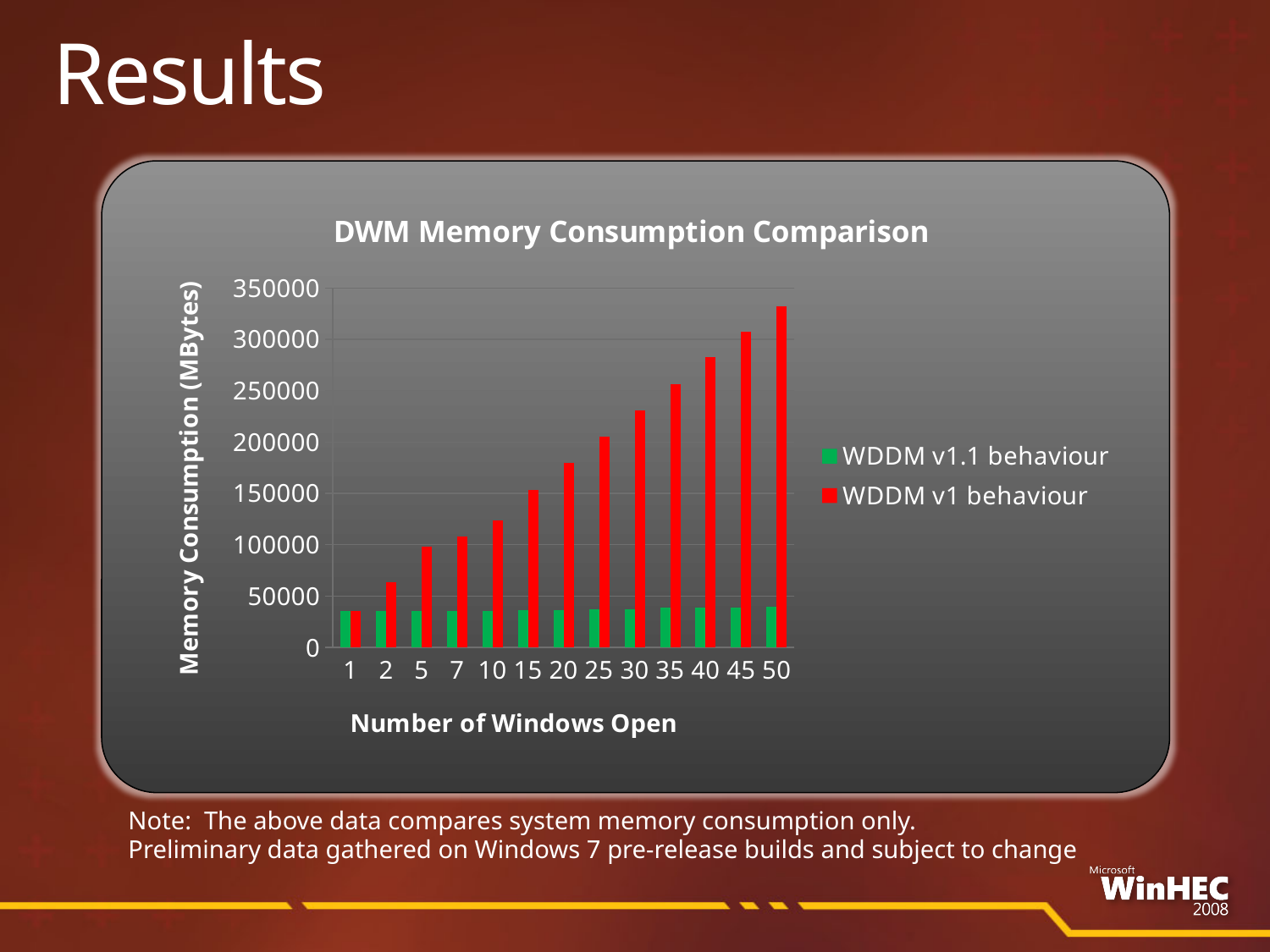
Is the WDDM v1 behaviour value at 20 windows open greater or less than 200000? less What is the title of the chart? DWM Memory Consumption Comparison How many series does the legend list? 2 Is the WDDM v1 behaviour value at 50 windows open greater or less than 300000? greater Do the WDDM v1 behaviour values rise or fall as the number of windows open increases? rise What is the label of the y axis? Memory Consumption (MBytes) Is the WDDM v1.1 behaviour value at 50 windows open greater or less than 50000? less For which number of windows open is the WDDM v1 behaviour value highest? 50 How many categories (numbers of windows open) are shown on the x axis? 13 At 50 windows open, which series has the larger value, WDDM v1.1 behaviour or WDDM v1 behaviour? WDDM v1 behaviour What kind of chart is shown on the slide? bar chart For which number of windows open is the WDDM v1 behaviour value lowest? 1